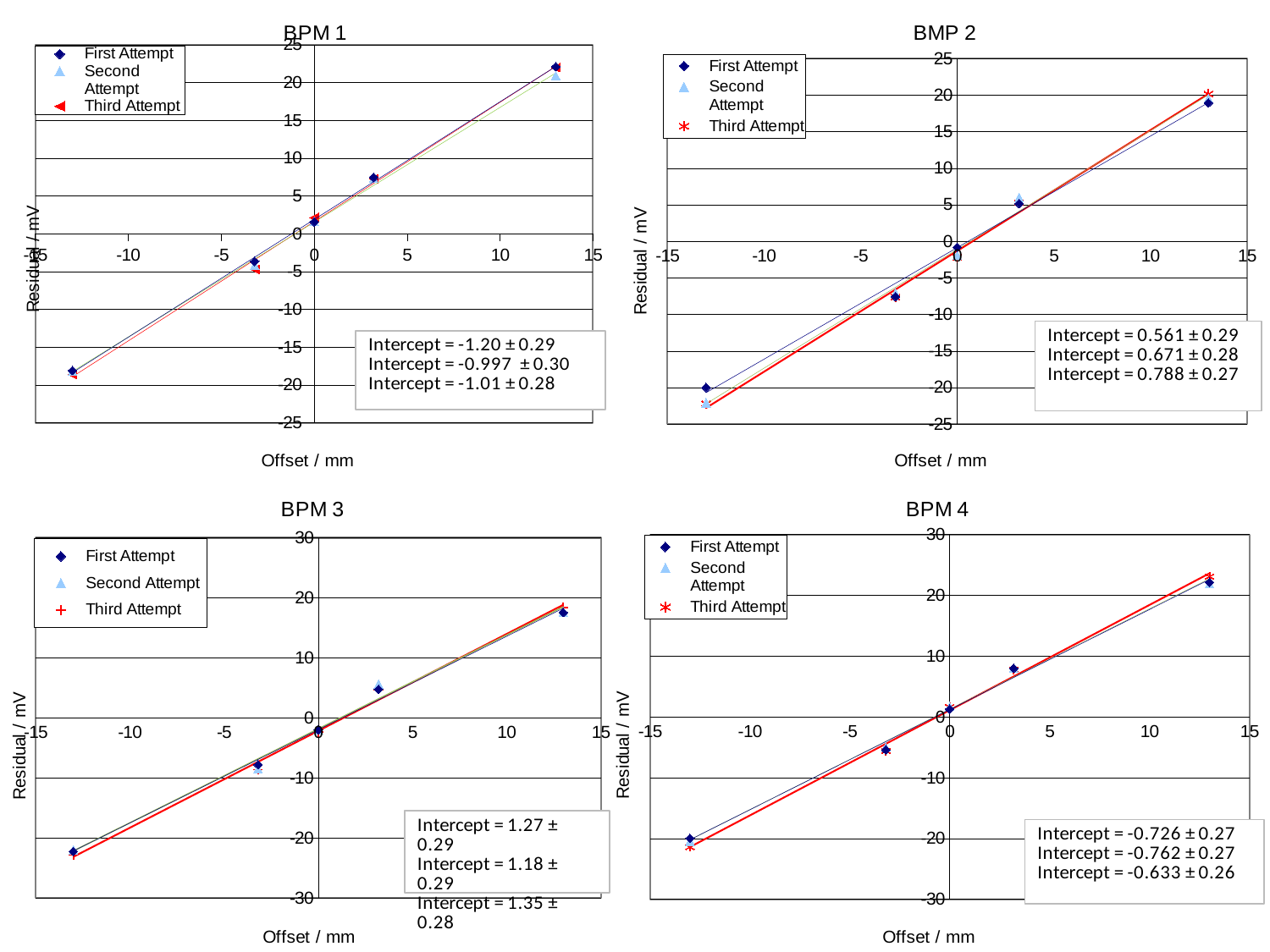
On the BPM 4 chart, is the Third Attempt value at an offset of about 13 mm greater or less than 20? greater On the BPM 3 chart, how many data points does the First Attempt series have? 5 On the BMP 2 chart, is the First Attempt value at an offset of about -13 mm greater or less than -15? less On the BPM 4 chart, what is the y-axis title? Residual / mV On the BPM 1 chart, is the Third Attempt value at an offset of about -3 mm greater or less than 0? less On the BPM 1 chart, do the residual values rise or fall as the offset increases? rise On the BPM 1 chart, how many series does the legend list? 3 On the BMP 2 chart, what is the x-axis title? Offset / mm What kind of chart is the BPM 1 chart? scatter chart